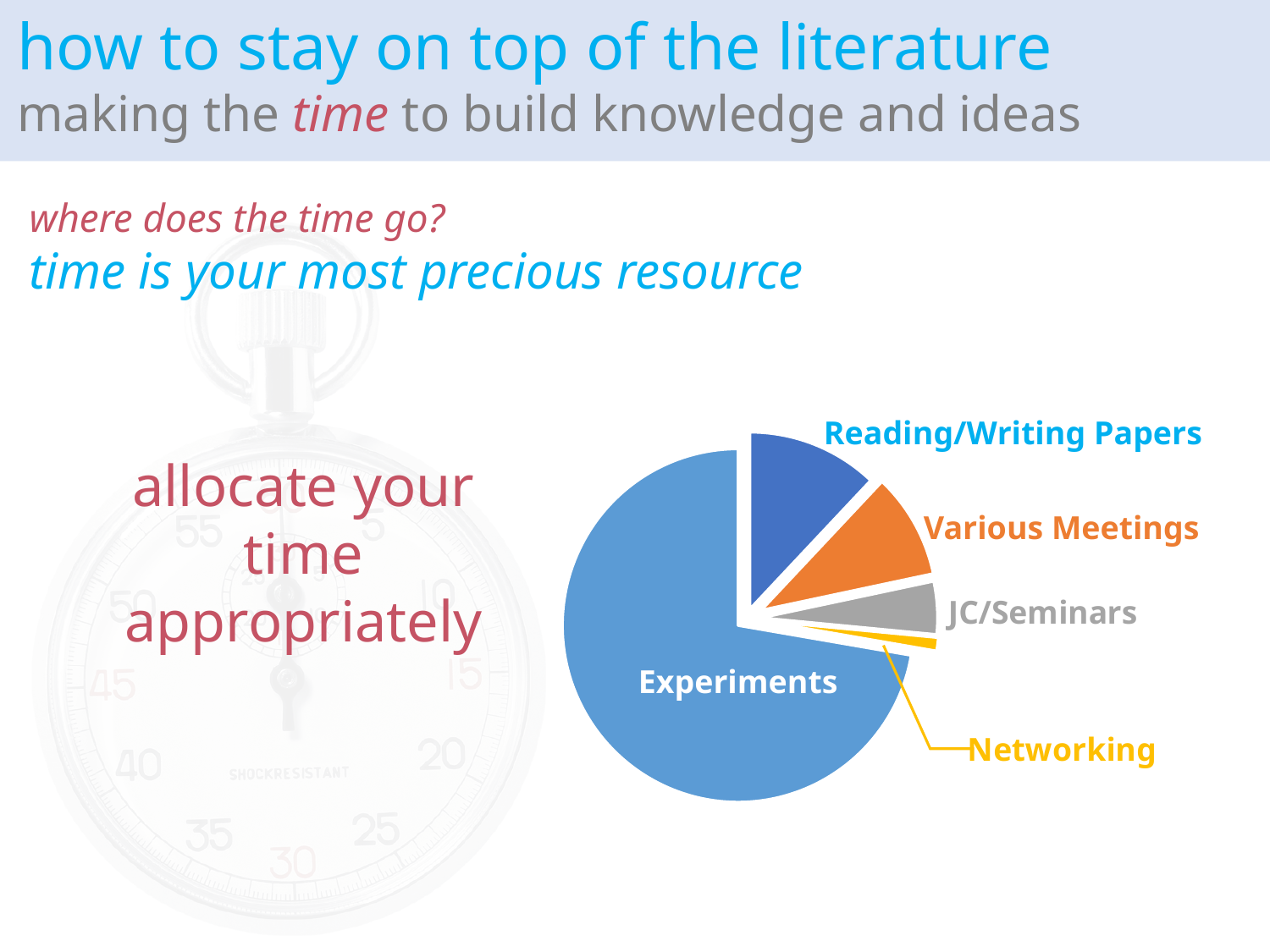
What colour is the Various Meetings slice in the pie chart? orange What kind of chart is shown on the slide? pie chart Which category takes up the smallest share of the pie chart? Networking Which slice is larger, JC/Seminars or Networking? JC/Seminars Which category is labelled in yellow on the pie chart? Networking Which slice is larger, Reading/Writing Papers or Networking? Reading/Writing Papers Which category takes up the largest share of the pie chart? Experiments Which slice is larger, Experiments or Reading/Writing Papers? Experiments How many slices does the pie chart have? 5